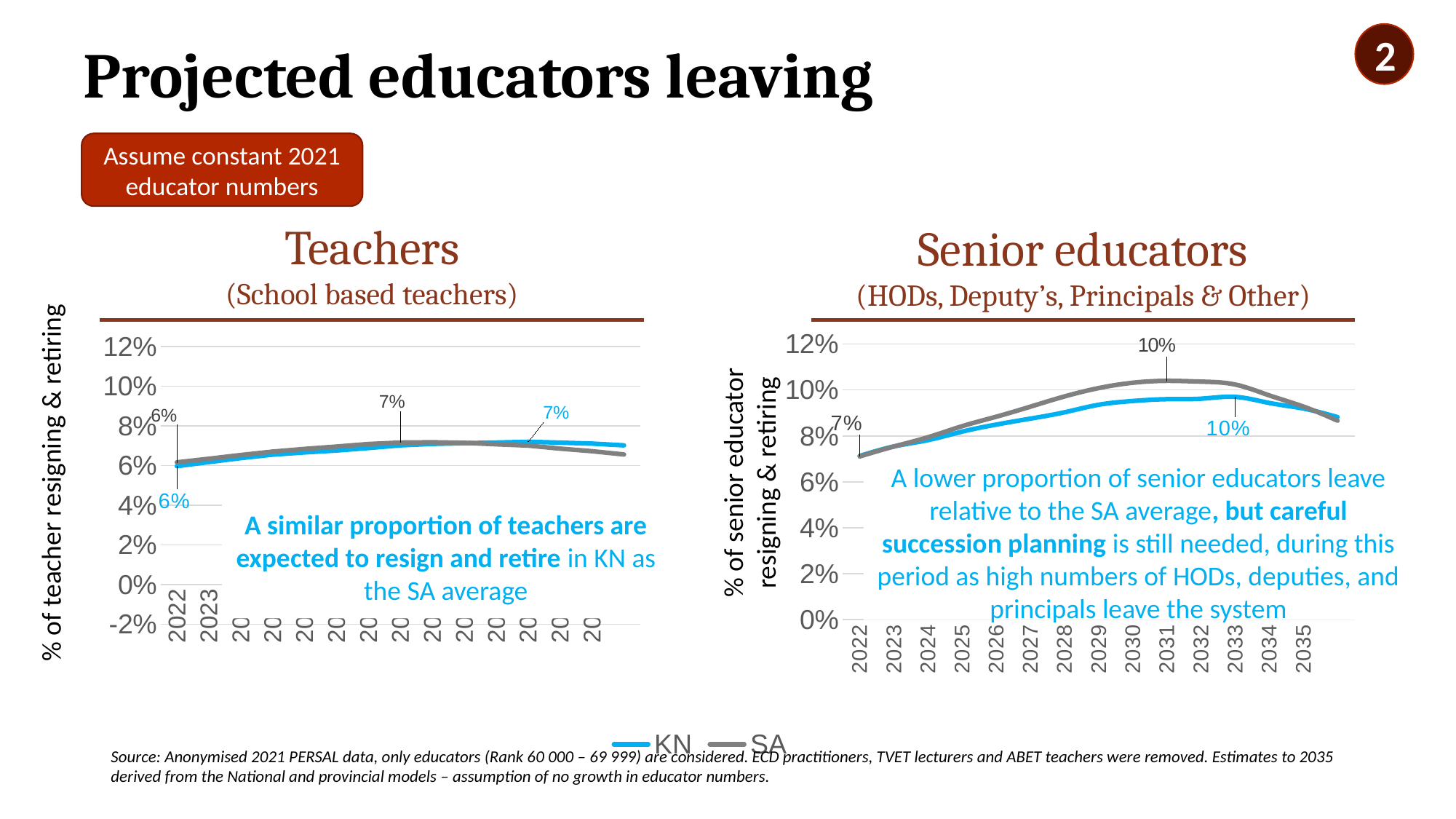
In the Senior educators chart, how many years are shown on the x axis? 14 In the Senior educators chart, is the KN value for 2022 greater or less than 8%? less In the Senior educators chart, does the SA series rise or fall from 2022 to 2031? Rise In the Senior educators chart, what is the labelled KN value in 2033? 10% In the Senior educators chart, what is the labelled SA value in 2031? 10% In the Senior educators chart, in which year does the SA series reach its highest value? 2031 What type of chart is the Teachers chart? Line chart In the Senior educators chart, which series is higher in 2028, KN or SA? SA In the Teachers chart, what is the labelled KN value in 2022? 6% In the Teachers chart, what is the labelled SA value in 2022? 6% How many series does the legend list for the charts? 2 What colour is the KN series in the legend? Blue